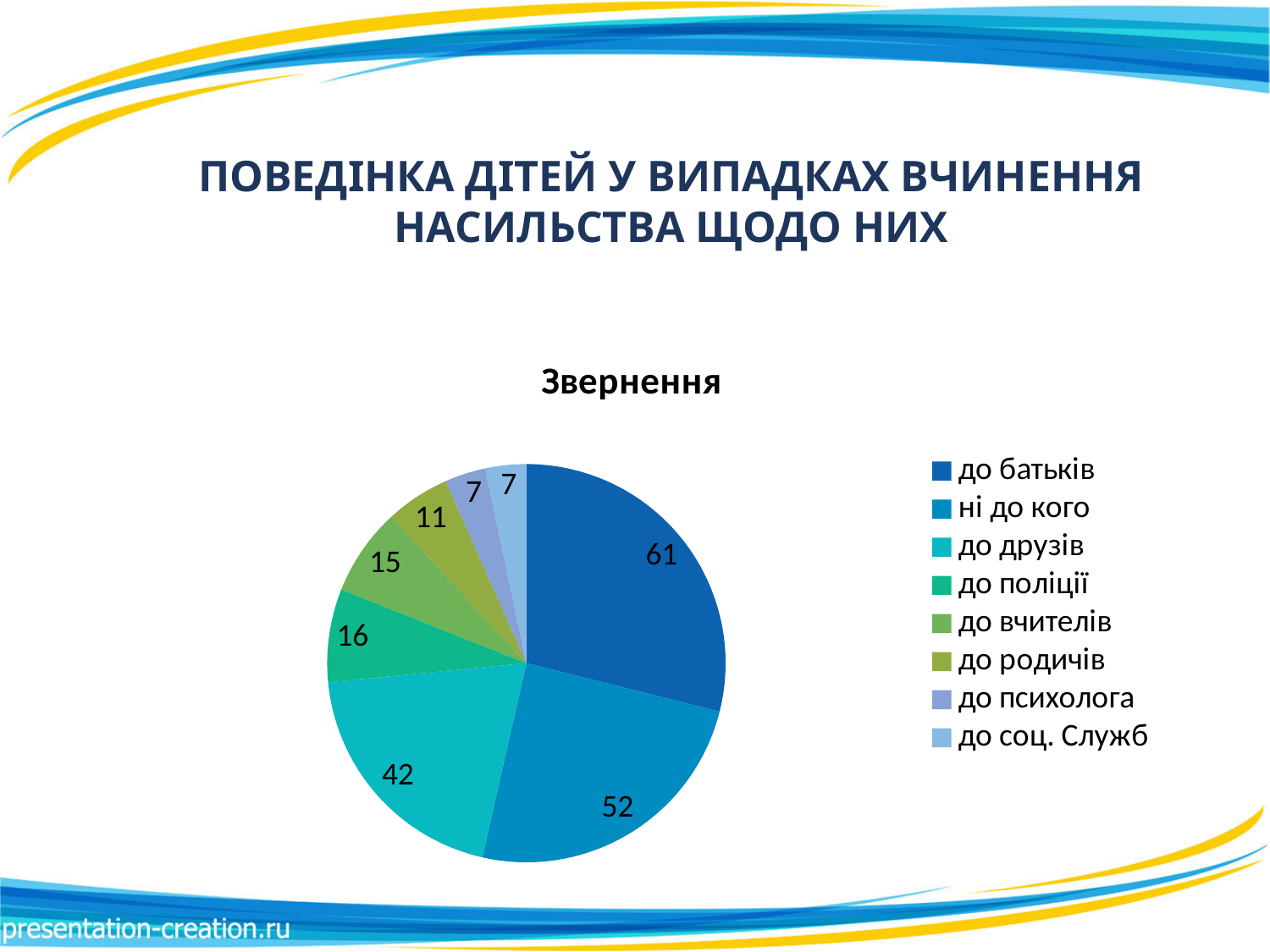
Which is larger, the value for "до друзів" or the value for "до поліції"? до друзів Which two categories share the smallest value in the pie chart? до психолога and до соц. Служб What kind of chart is shown on the slide? pie chart How many categories are shown in the pie chart? 8 What is the difference between the values for "до друзів" and "до вчителів"? 27 What is the value for "ні до кого" in the pie chart? 52 What is the value for "до батьків" in the pie chart? 61 What is the title of the chart? Звернення What is the value for "до родичів" in the pie chart? 11 What is the value for "до поліції" in the pie chart? 16 Which category has the largest slice in the pie chart? до батьків What is the difference between the values for "до батьків" and "ні до кого"? 9